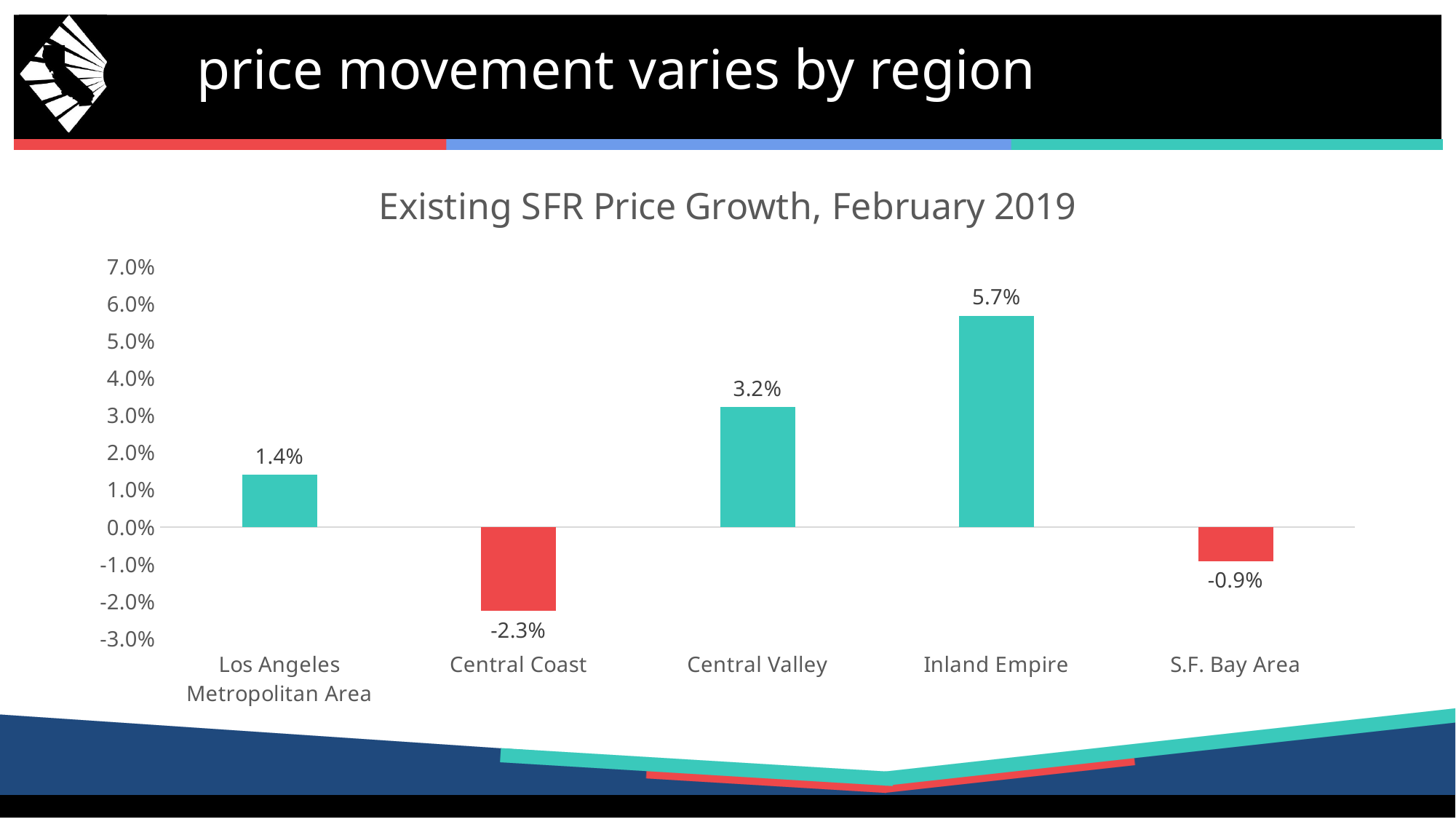
What is the title of the chart? Existing SFR Price Growth, February 2019 How many regions show negative price growth? 2 Which has the larger price growth, Los Angeles Metropolitan Area or Central Valley? Central Valley Is the value for Central Valley greater or less than 2.0%? greater What is the difference between the price growth of Inland Empire and Central Valley? 2.5% What is the price growth value for Inland Empire? 5.7% Which region has the lowest price growth? Central Coast What kind of chart is shown on the slide? Bar chart What is the price growth value for Central Coast? -2.3% What is the price growth value for the S.F. Bay Area? -0.9% How many regions are shown in the chart? 5 Which region has the highest price growth? Inland Empire